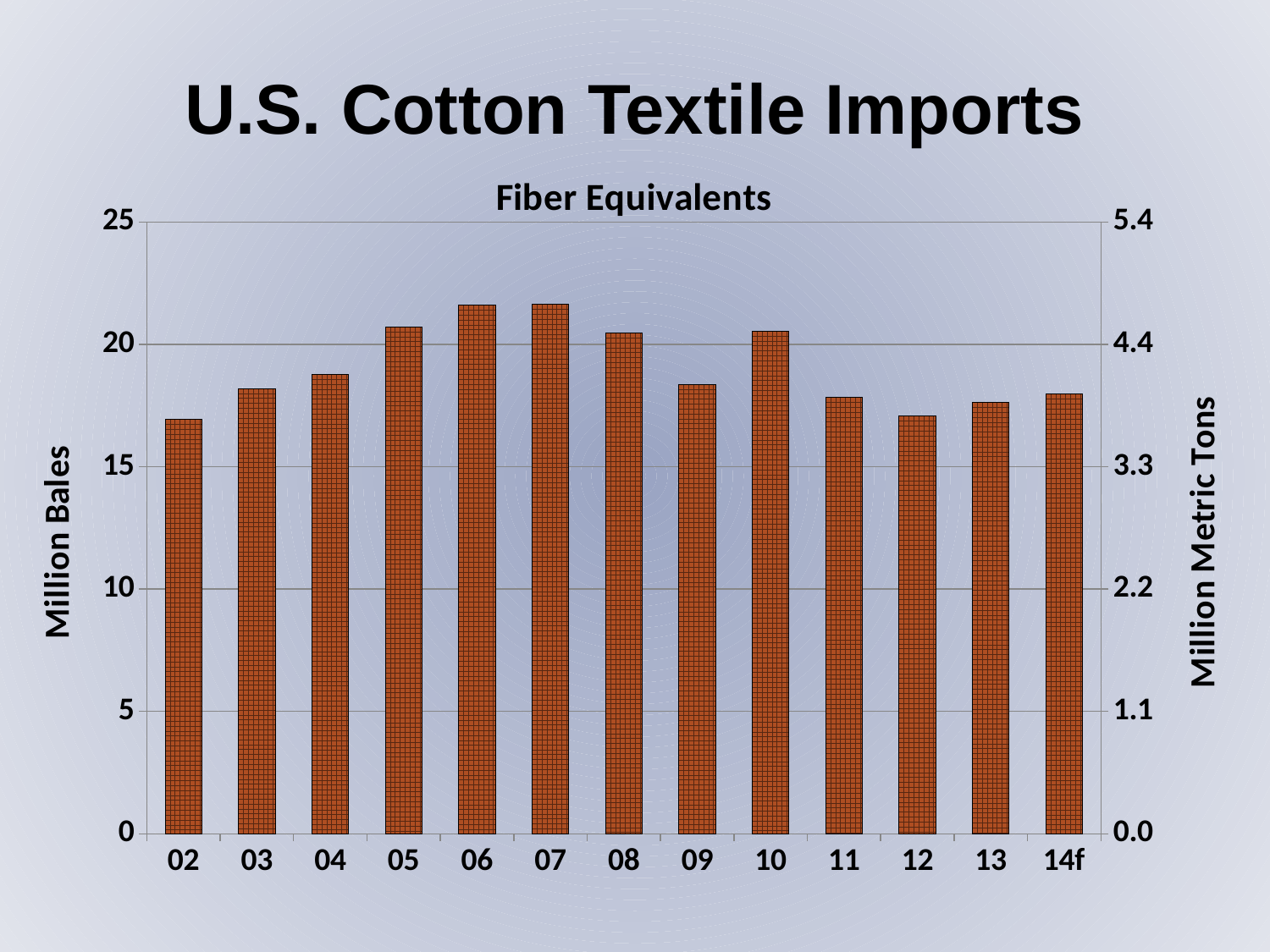
Is the value for 05 greater or less than 20 million bales? greater Which has the larger value, 10 or 11? 10 What is the label on the right vertical axis? Million Metric Tons Is the value for 02 greater or less than 20 million bales? less Is the value for 12 greater or less than 20 million bales? less Which has the larger value, 05 or 04? 05 Do the values rise or fall from 02 to 06? rise What kind of chart is shown on the slide? bar chart What is the label on the left vertical axis? Million Bales How many years (categories) are plotted on the x axis? 13